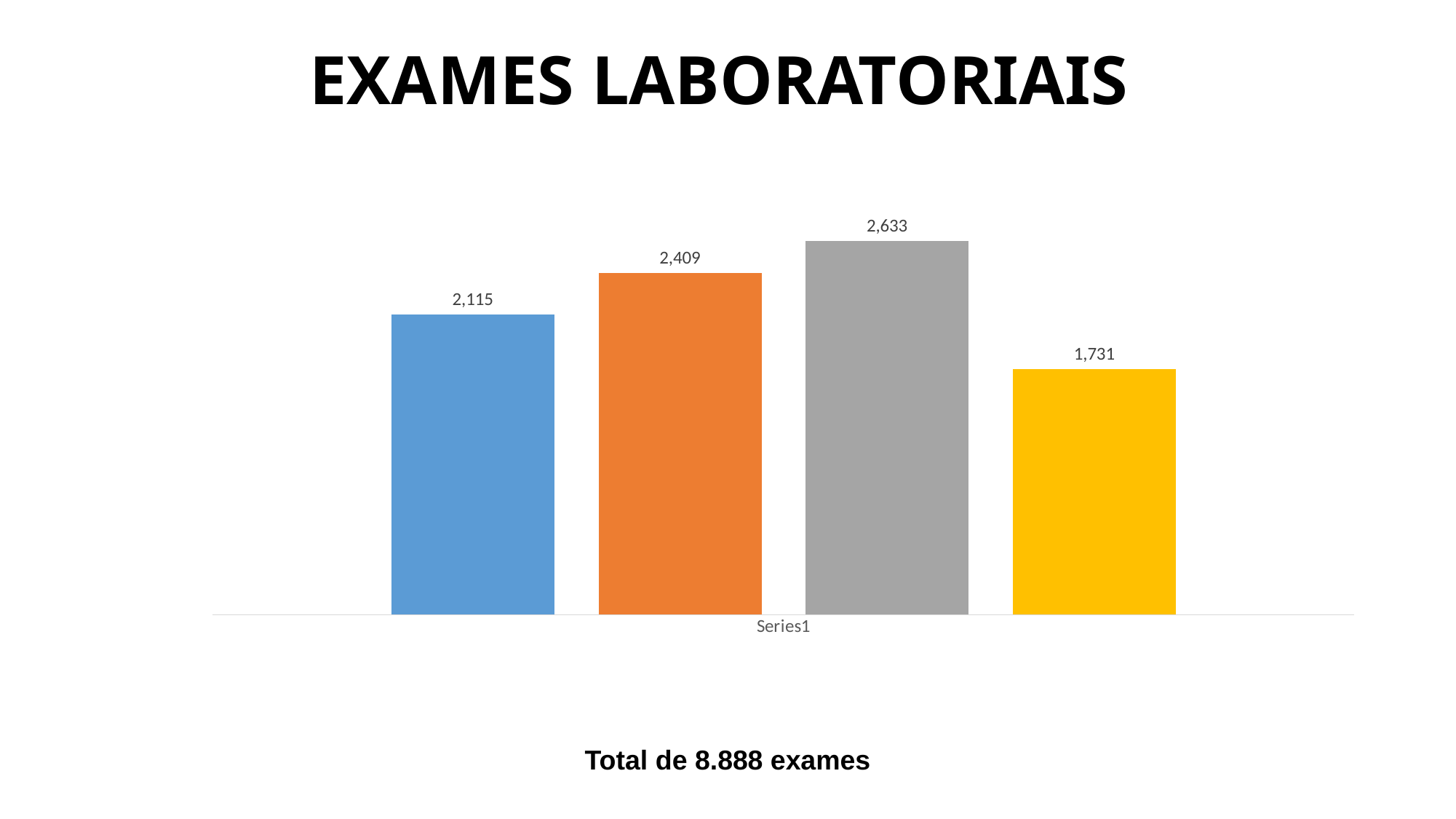
How many bars are plotted in the chart? 4 What is the difference between the orange bar and the blue bar? 294 What is the value shown on the orange bar? 2,409 What is the difference between the gray bar and the yellow bar? 902 What type of chart is shown on the slide? Bar chart Which bar has the highest value? The gray bar (2,633) What is the value shown on the yellow bar? 1,731 What is the value shown on the blue bar? 2,115 What is the value shown on the gray bar? 2,633 Which bar has the lowest value? The yellow bar (1,731) What is the title of the slide? EXAMES LABORATORIAIS Which is larger, the blue bar or the orange bar? The orange bar